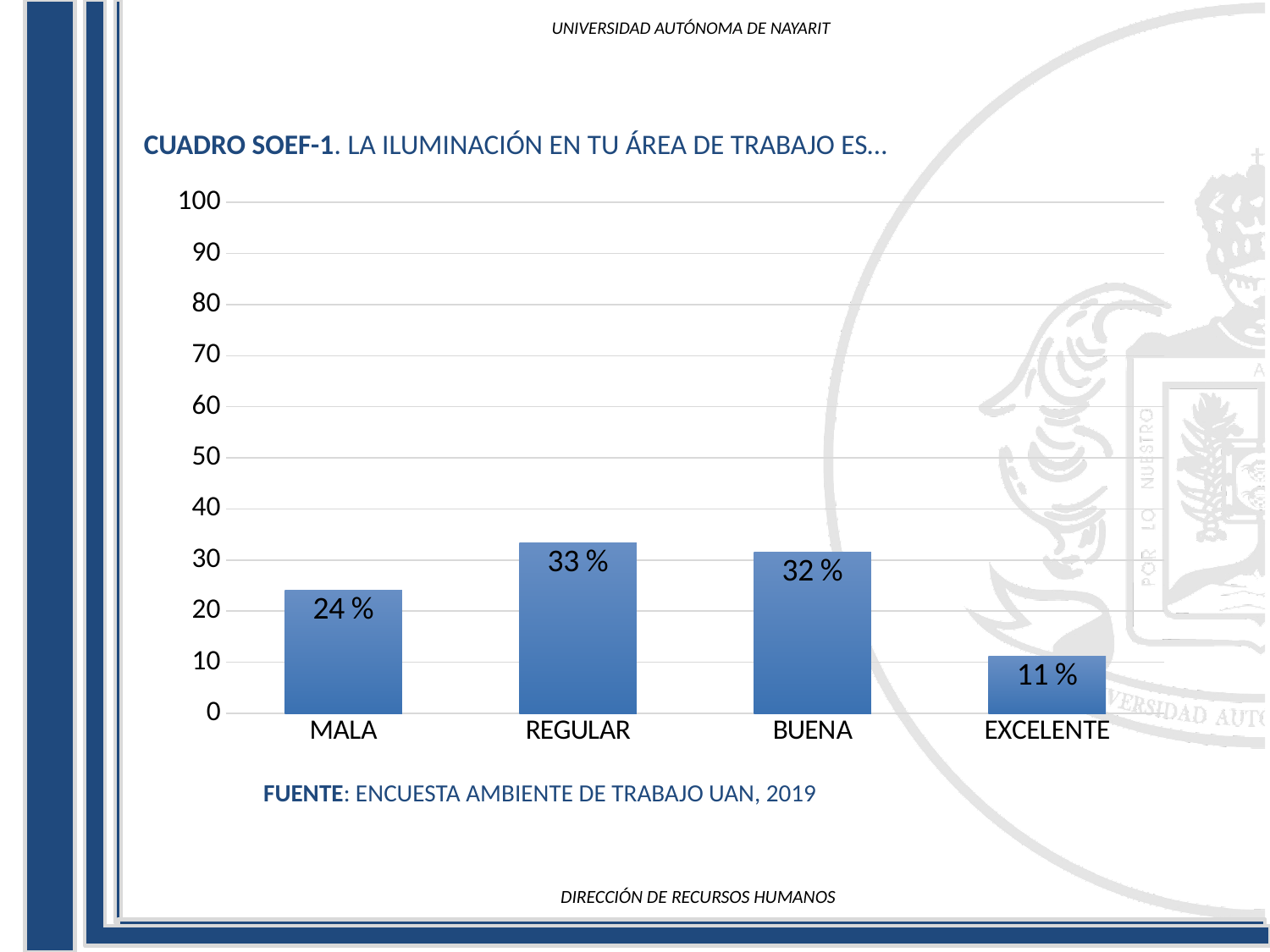
What is the difference between the values for BUENA and EXCELENTE? 21 % Which is larger, the value for MALA or the value for EXCELENTE? MALA How many categories are shown on the x axis? 4 Which category has the lowest value? EXCELENTE What is the source cited below the chart? ENCUESTA AMBIENTE DE TRABAJO UAN, 2019 What is the value for REGULAR? 33 % What is the difference between the values for REGULAR and MALA? 9 % Which category has the highest value? REGULAR What kind of chart is shown on the slide? Bar chart What is the value for BUENA? 32 % What is the value for MALA? 24 % What is the value for EXCELENTE? 11 %